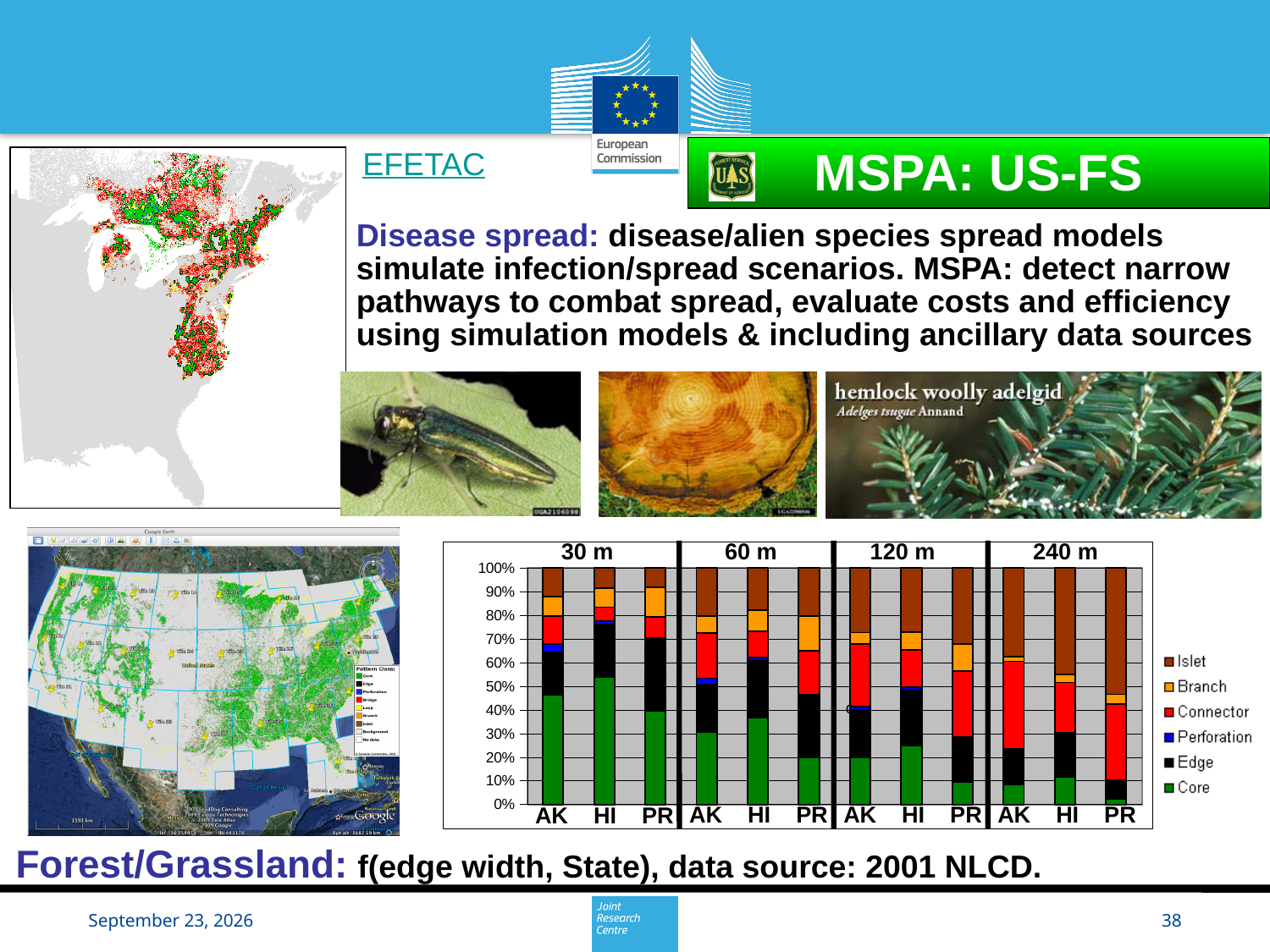
In the bar chart, is the Core share for PR at 60 m greater or less than 30%? less In the bar chart, does the Core share for AK rise or fall as the edge width increases from 30 m to 240 m? fall Which pattern classes are listed in the legend of the bar chart? Islet, Branch, Connector, Perforation, Edge, Core In the bar chart, which state has the largest Core share at 30 m? HI In the bar chart, which state has the smallest Core share at 240 m? PR In the bar chart, is the Core share for AK at 30 m greater or less than 40%? greater What kind of chart is shown at the bottom of the slide? stacked bar chart How many series does the legend of the bar chart list? 6 How many bars are plotted in the bar chart in total? 12 Which edge widths are shown as groups along the x axis of the bar chart? 30 m, 60 m, 120 m, 240 m In the bar chart, is the Core share for AK larger at 30 m or at 240 m? 30 m In the bar chart, is the Core share for PR at 240 m greater or less than 10%? less